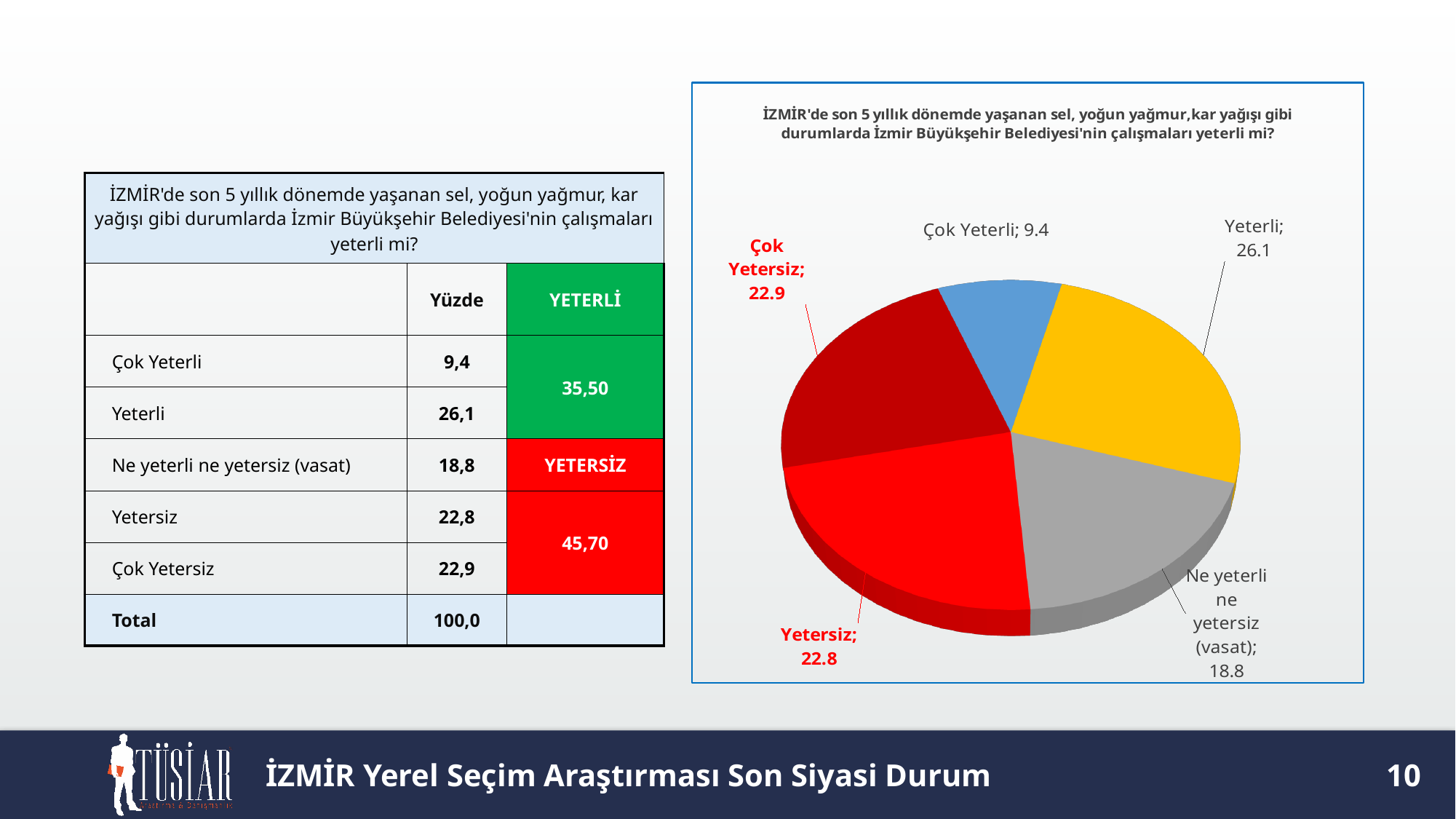
Which category has the smallest slice in the pie chart? Çok Yeterli What kind of chart is shown on the slide? pie chart What is the value shown for Çok Yeterli in the pie chart? 9.4 What is the value shown for Yetersiz in the pie chart? 22.8 Which category has the largest slice in the pie chart? Yeterli What colour is the Yeterli slice in the pie chart? yellow How many slices does the pie chart have? 5 Which is larger in the pie chart, Yeterli or Ne yeterli ne yetersiz (vasat)? Yeterli What is the value shown for Ne yeterli ne yetersiz (vasat) in the pie chart? 18.8 What is the value shown for Yeterli in the pie chart? 26.1 What is the value shown for Çok Yetersiz in the pie chart? 22.9 What is the difference between the values for Yeterli and Çok Yeterli in the pie chart? 16.7